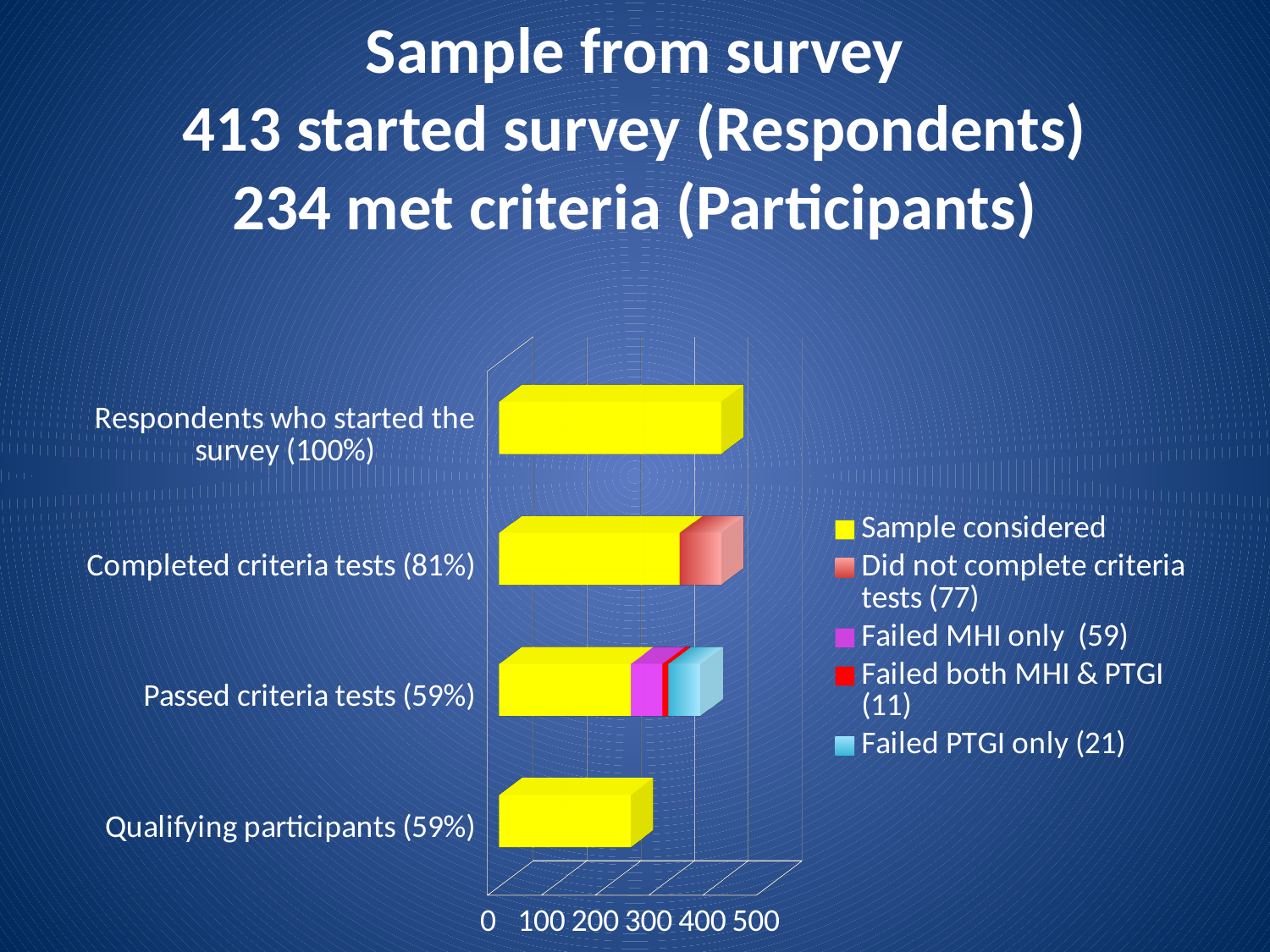
Is the bar for Qualifying participants greater or less than 300? less Is the total bar for Respondents who started the survey greater or less than 300? greater According to the legend, how many respondents failed both MHI & PTGI? 11 How many series does the chart legend list? 5 According to the legend, how many respondents did not complete the criteria tests? 77 What kind of chart is shown on the slide? bar chart According to the legend, how many respondents failed MHI only? 59 How many categories are plotted on the chart? 4 Which category has the shortest total bar? Qualifying participants (59%) Which colour represents the 'Sample considered' series in the legend? yellow According to the legend, how many respondents failed PTGI only? 21